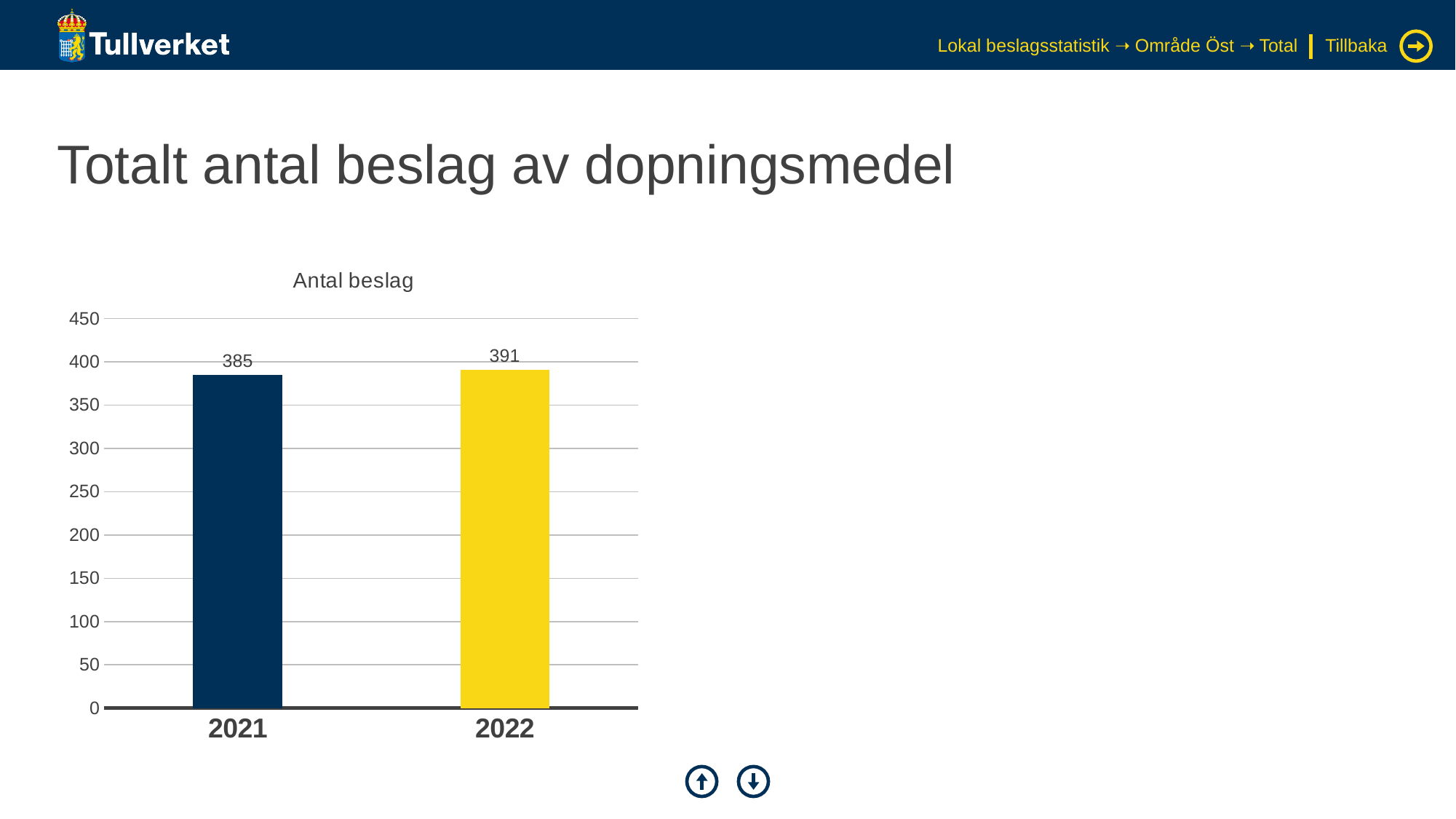
What is the value for 2021? 385 What is the title of the chart? Antal beslag What is the difference between the values for 2022 and 2021? 6 What colour is the bar for 2022? yellow Which year has the lower number of seizures? 2021 What is the value for 2022? 391 How many years are shown on the x axis? 2 Is the value for 2021 greater or less than 400? less Is the value for 2022 greater or less than 350? greater Do the values rise or fall from 2021 to 2022? rise What kind of chart is shown on the slide? bar chart Which year has the higher number of seizures? 2022